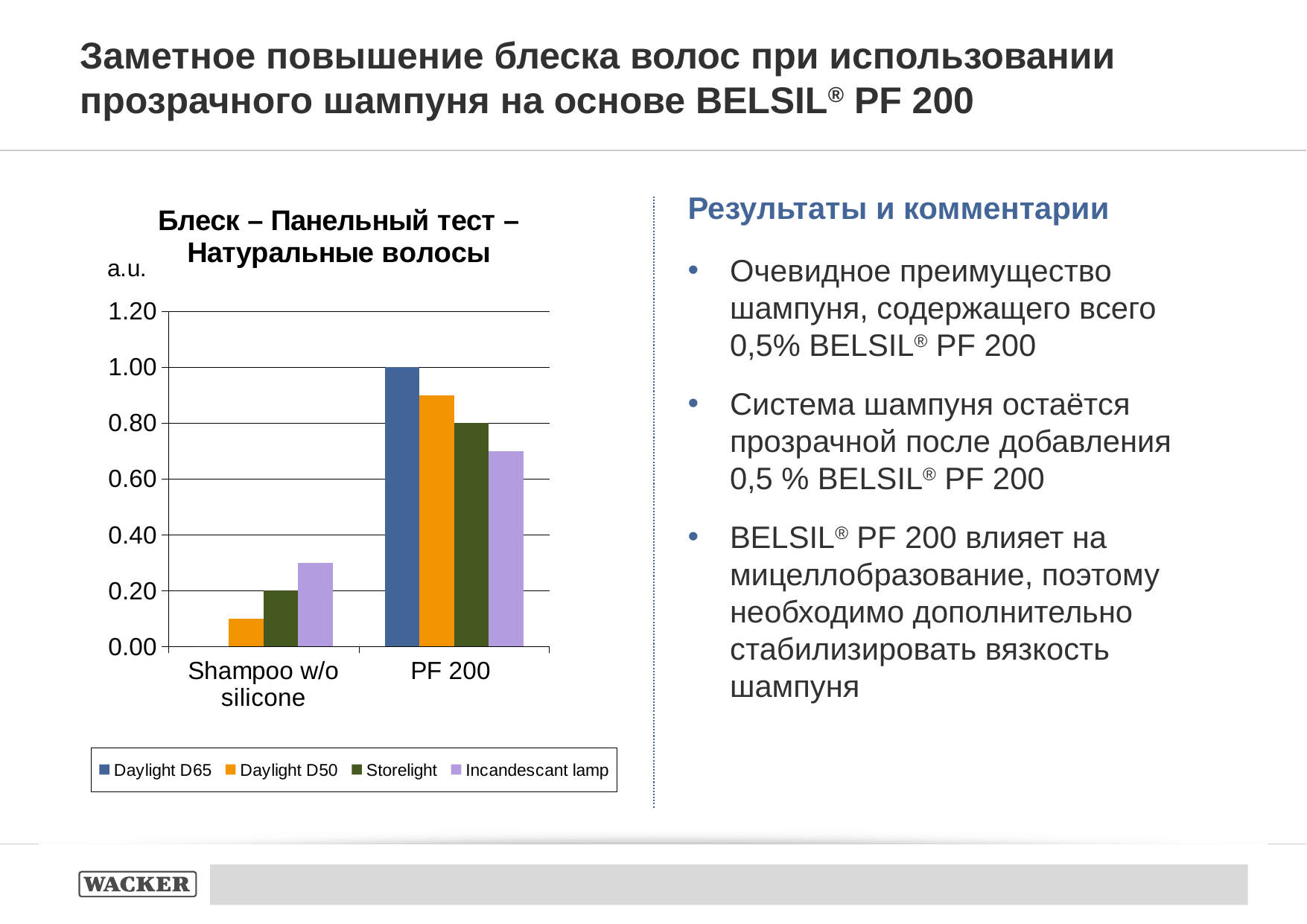
Which series has the lowest value for PF 200? Incandescant lamp What unit is shown on the y axis of the chart? a.u. Is the Incandescant lamp value for Shampoo w/o silicone greater or less than 0.20? greater What is the Storelight value for PF 200? 0.80 How many series does the chart legend list? 4 Is the Daylight D50 value for PF 200 greater or less than 0.80? greater How many categories are shown on the x axis of the chart? 2 What is the Daylight D65 value for PF 200? 1.00 What is the Storelight value for Shampoo w/o silicone? 0.20 Which series has the highest value for PF 200? Daylight D65 What kind of chart is shown on the slide? bar chart What is the difference between the Daylight D65 and Storelight values for PF 200? 0.20